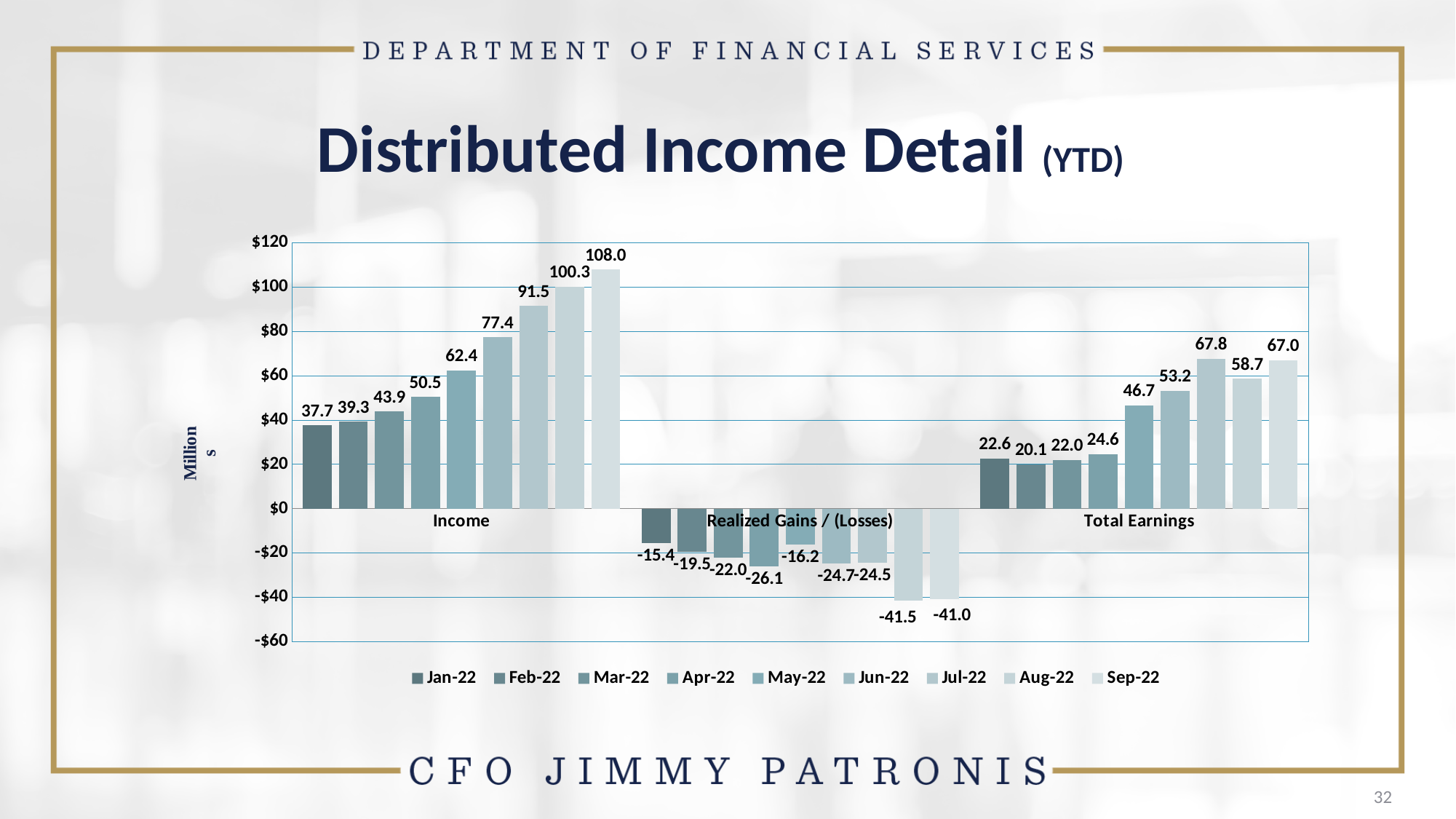
What is the Total Earnings value for May-22? 46.7 What is the difference between the Income values for Sep-22 and Jan-22? 70.3 Do the Income values rise or fall from Jan-22 to Sep-22? rise Is the Income value for Jun-22 greater or less than $60? greater Which month has the lowest Income value? Jan-22 What kind of chart is shown on the slide? bar chart Which month has the highest Total Earnings value? Jul-22 What is the Realized Gains / (Losses) value for Aug-22? -41.5 How many categories are shown on the x axis? 3 Which is larger, the Total Earnings value for Jul-22 or for Sep-22? Jul-22 How many series does the legend list? 9 What is the Income value for Sep-22? 108.0